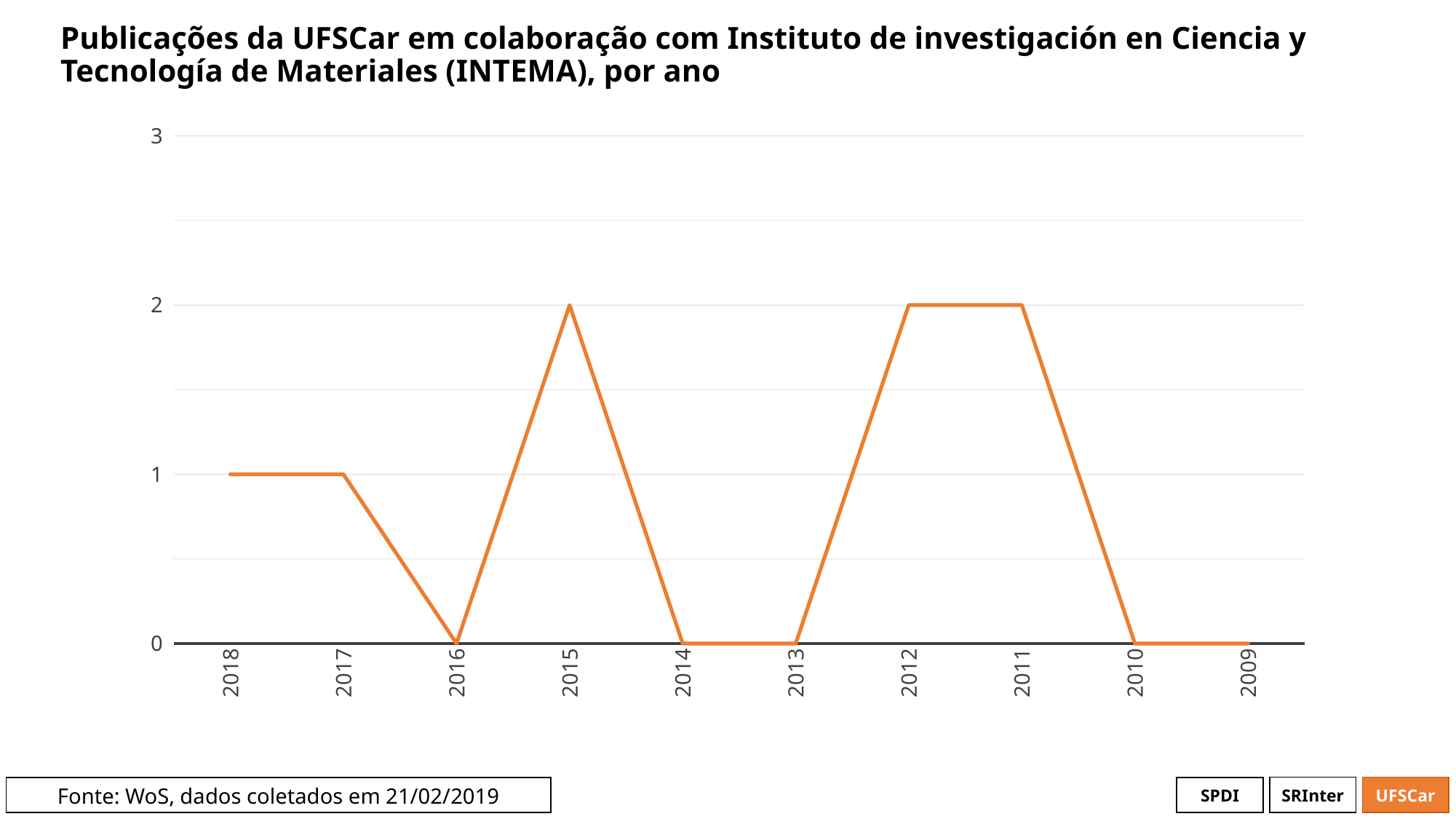
What is the value for 2009? 0 What is the highest value shown on the y axis? 3 What is the value for 2011? 2 Which is larger, the value for 2015 or the value for 2017? 2015 What is the value for 2016? 0 What is the value for 2015? 2 Does the value rise or fall from 2017 to 2016? fall How many years are plotted on the x axis? 10 What kind of chart is shown on the slide? line chart Which years reach the highest value on the chart? 2015, 2012, 2011 What is the difference between the values for 2015 and 2016? 2 What is the value for 2018? 1